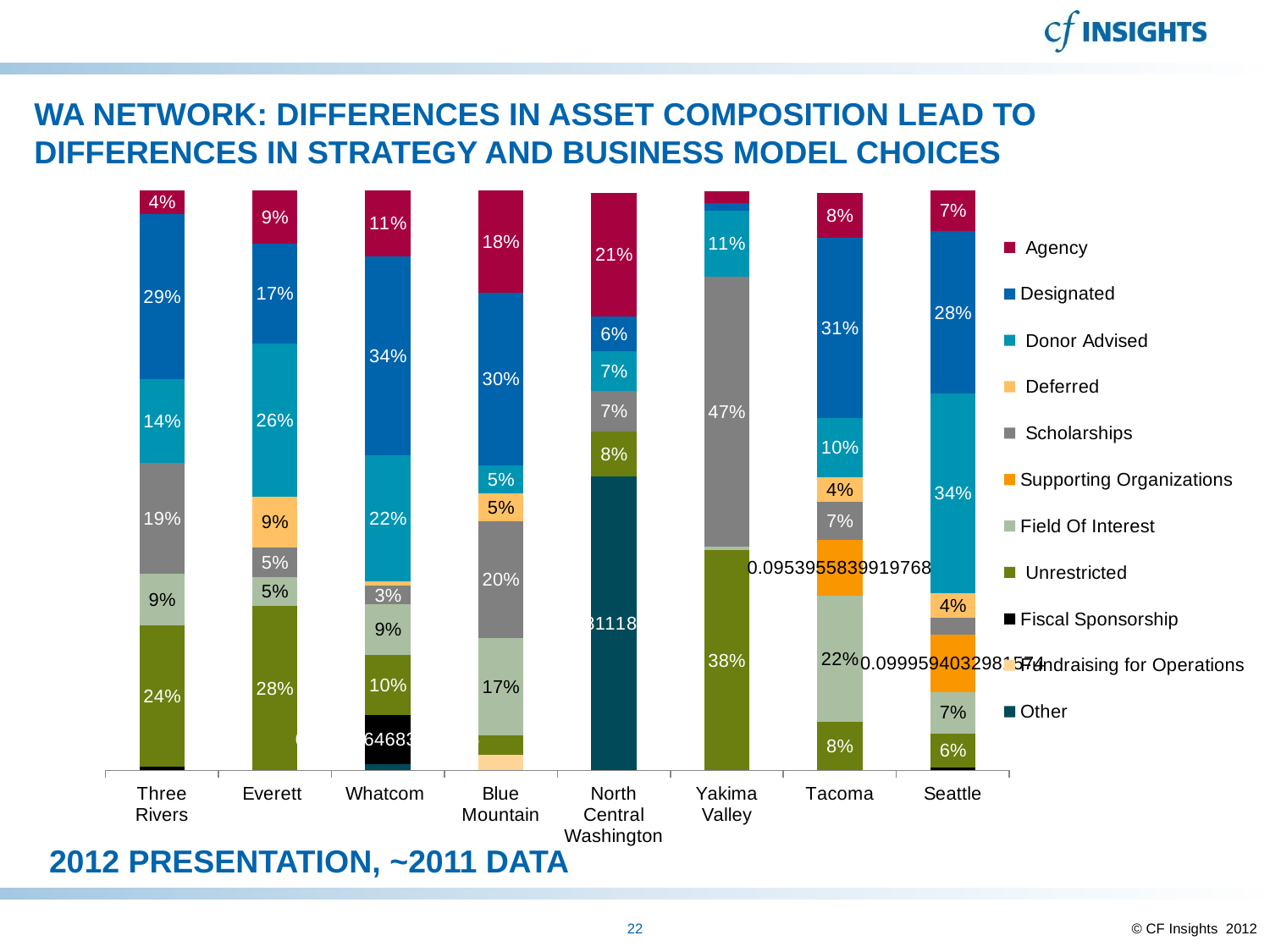
What is the Scholarships share for Yakima Valley? 47% Which is larger, the Designated share for Tacoma or the Designated share for Seattle? Tacoma What is the Agency share for North Central Washington? 21% What is the difference between the Unrestricted share for Yakima Valley and the Unrestricted share for Three Rivers? 14% What is the Designated share for Whatcom? 34% Which foundation has the largest Scholarships segment? Yakima Valley What is the Unrestricted share for Everett? 28% What type of chart is shown on the slide? Stacked bar chart How many series does the legend list? 11 How many community foundations (categories) are shown along the x axis? 8 What is the Donor Advised share for Seattle? 34% Which legend entry is shown in the darkest red colour at the top of the bars? Agency